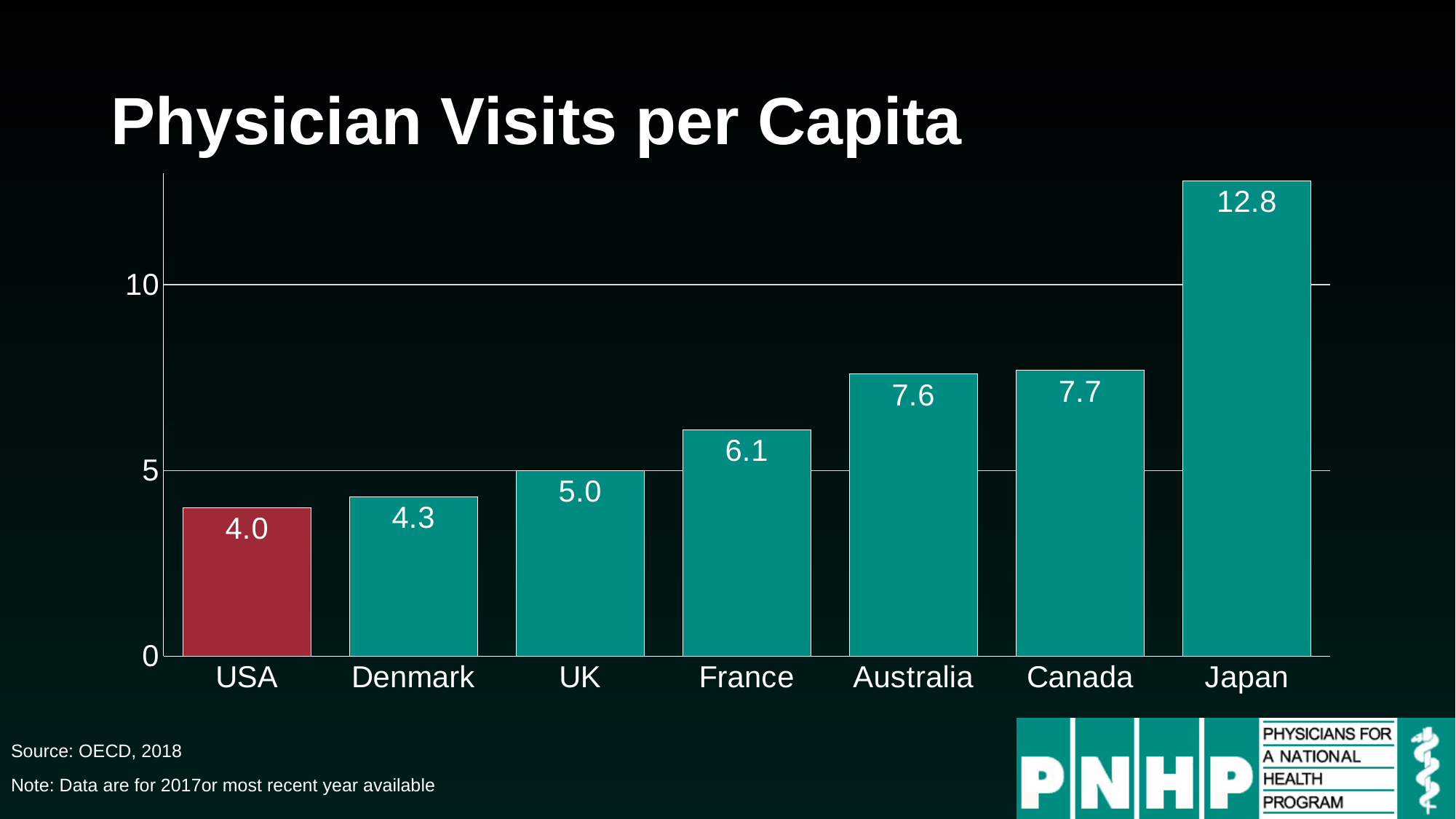
Which is larger, the value for France or the value for Denmark? France What is the value for the USA? 4.0 Which country has the lowest physician visits per capita? USA What is the value for France? 6.1 What is the difference between Australia's and Denmark's values? 3.3 What is the difference between Japan's and the USA's values? 8.8 Which country has the highest physician visits per capita? Japan Which country's bar is coloured differently (red) from the others? USA What kind of chart is shown on the slide? Bar chart How many countries are shown in the chart? 7 What is the value for Japan? 12.8 Is the value for Canada greater or less than 5? greater